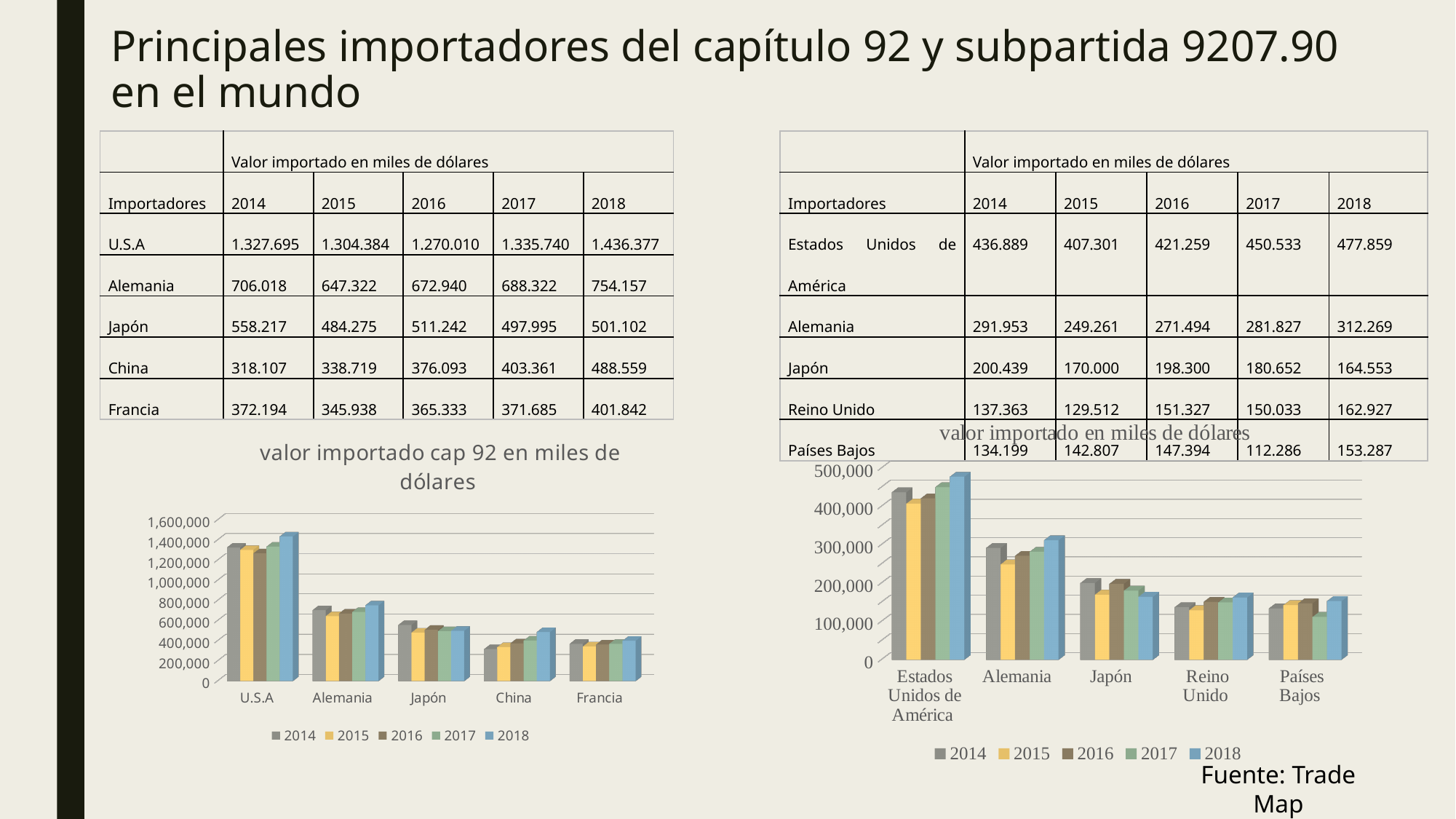
In the left chart, is the 2018 value for Alemania greater or less than 600,000? greater In the left chart, which importer has the highest value for 2018? U.S.A What kind of chart is the left chart titled 'valor importado cap 92 en miles de dólares'? bar chart In the left chart, do the values for China rise or fall from 2014 to 2018? rise In the right chart, which is larger for 2018: Alemania or Japón? Alemania In the right chart, is the 2018 value for Japón greater or less than 200,000? less In the left chart, what is the value for China in 2018, as printed in the table above it? 488.559 In the right chart, is the 2018 value for Estados Unidos de América greater or less than 400,000? greater In the right chart, which importer has the lowest value for 2017? Países Bajos How many series does the legend of the right chart list? 5 How many importer categories are shown on the x axis of the left chart? 5 In the left chart, what is the difference between the U.S.A values for 2018 and 2014, using the table values? 108.682